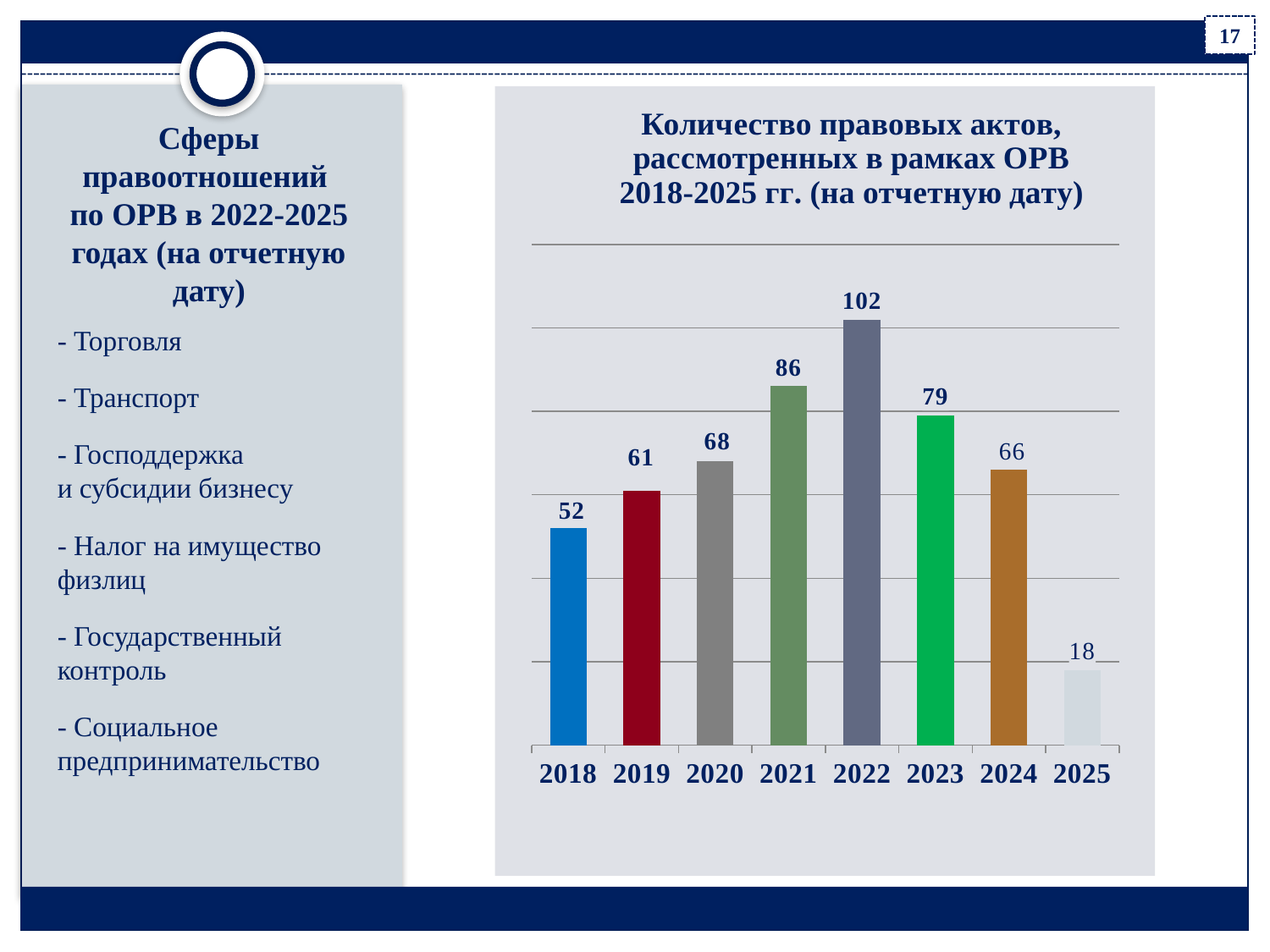
What is the difference between the values for 2024 and 2025? 48 Which year has the lowest value? 2025 What is the title of the chart? Количество правовых актов, рассмотренных в рамках ОРВ 2018-2025 гг. (на отчетную дату) What is the value for 2018? 52 Do the values rise or fall from 2018 to 2022? rise What is the difference between the values for 2022 and 2021? 16 What is the value for 2022? 102 What kind of chart is shown? bar chart Which is larger, the value for 2023 or the value for 2024? 2023 Which year has the highest value? 2022 How many years are shown on the x axis? 8 What is the value for 2025? 18